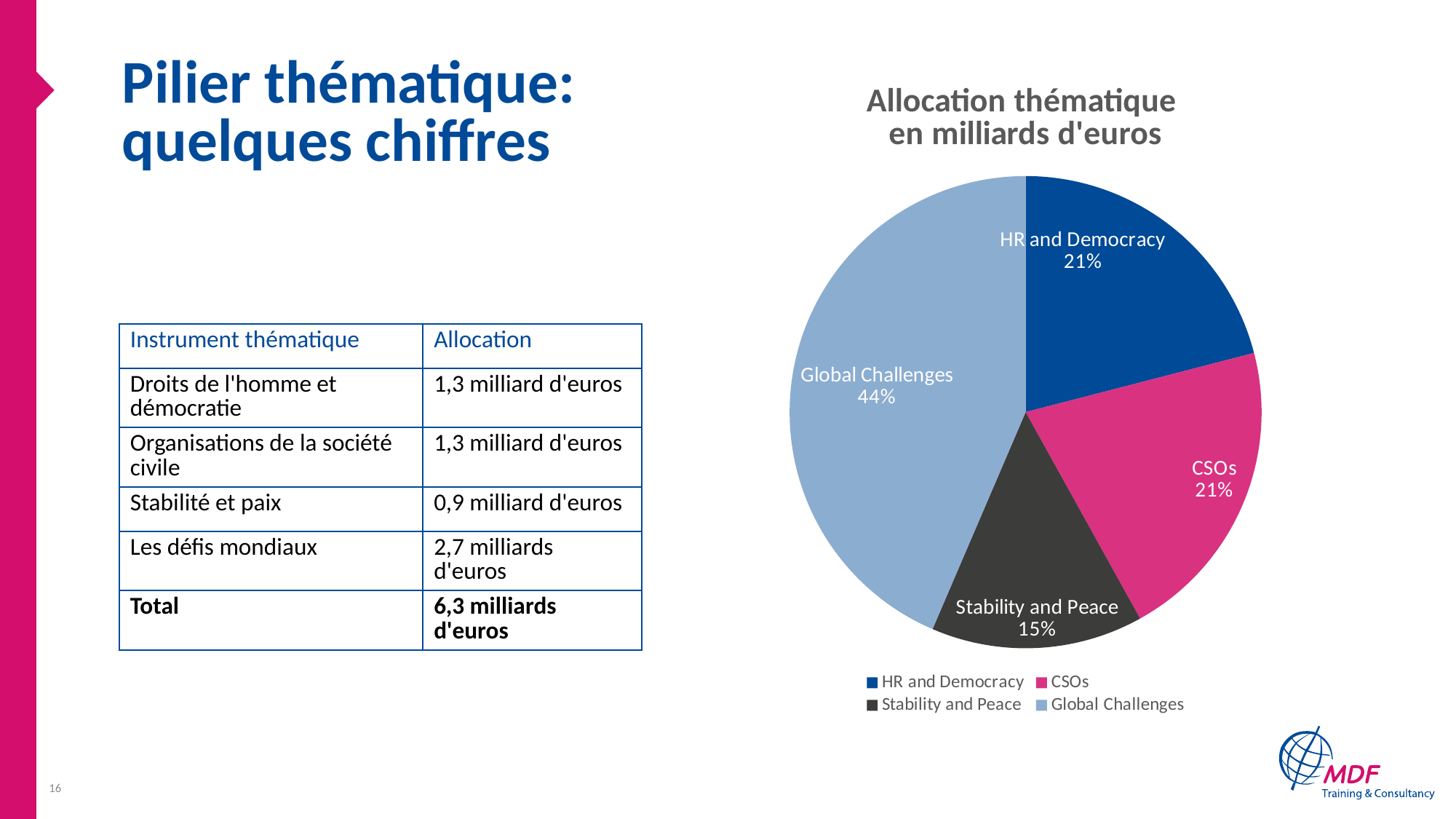
Which slice of the pie is the largest? Global Challenges How many entries does the legend list? 4 How many slices does the pie chart have? 4 What kind of chart is shown on the slide? pie chart What share of the pie does Global Challenges represent? 44% What is the value shown for CSOs? 21% What share of the pie does Stability and Peace represent? 15% Which slice of the pie is the smallest? Stability and Peace What is the difference in percentage points between Global Challenges and Stability and Peace? 29 What is the value shown for HR and Democracy? 21% What is the title of the chart? Allocation thématique en milliards d'euros Which is larger, the share for Global Challenges or the share for CSOs? Global Challenges